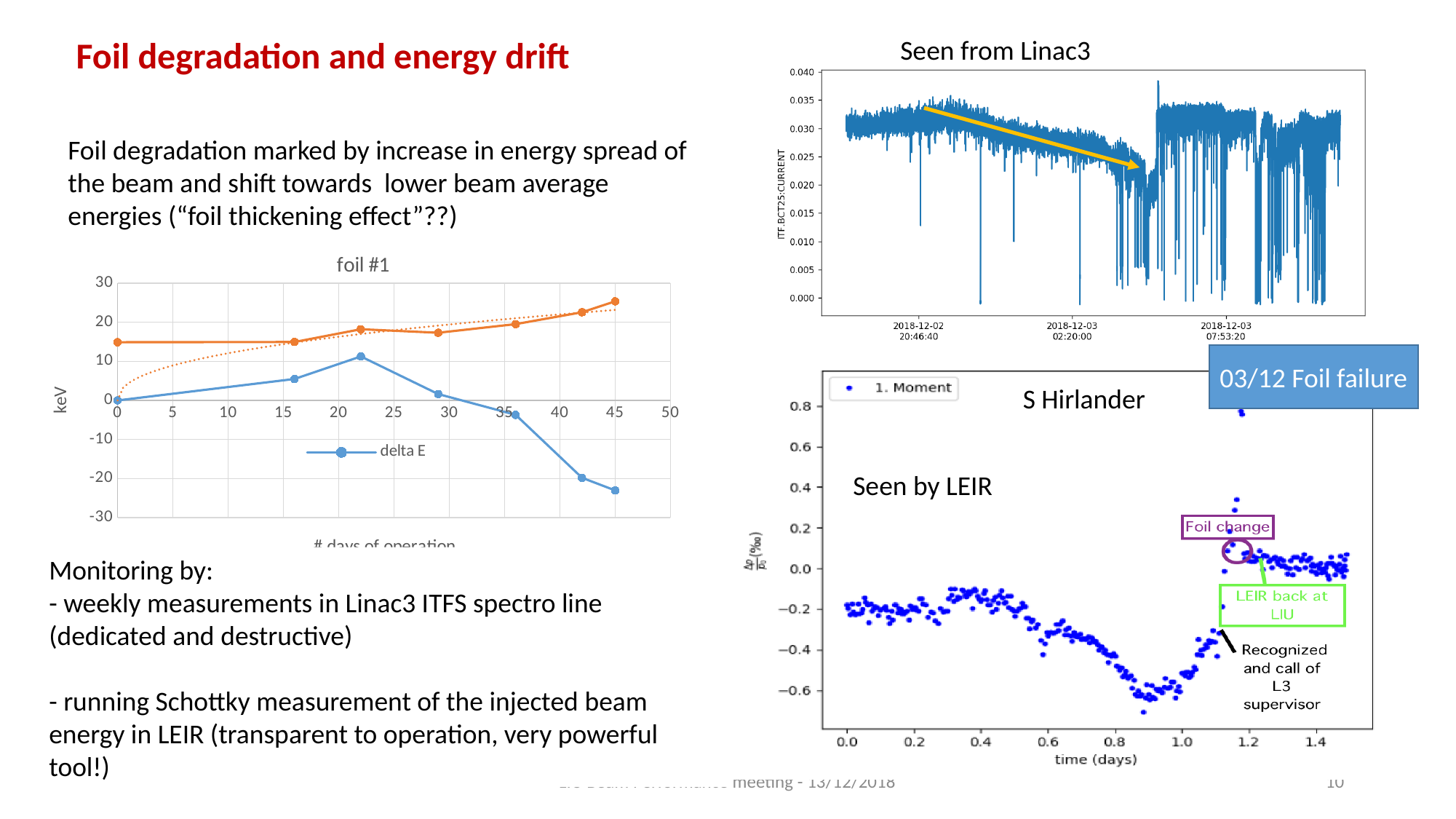
In the 'Seen by LEIR' chart, is the value at time 0.0 days greater or less than 0.0? less In the 'Seen from Linac3' chart, what is the label on the vertical axis? ITF.BCT25:CURRENT In the 'foil #1' chart, does the 'delta E' series rise or fall between 22 and 45 days of operation? fall In the 'foil #1' chart, is the 'delta E' value at 45 days greater or less than 0? less In the 'foil #1' chart, is the orange series value at 45 days greater or less than 20? greater In the 'foil #1' chart, how many data points does the 'delta E' series have? 7 In the 'foil #1' chart, what is the label on the vertical axis? keV In the 'foil #1' chart, at which number of days of operation does the 'delta E' series reach its highest value? 22 In the 'Seen by LEIR' chart, how many series does the legend list? 1 In the 'foil #1' chart, what kind of chart is it? line chart In the 'foil #1' chart, at which number of days of operation does the 'delta E' series reach its lowest value? 45